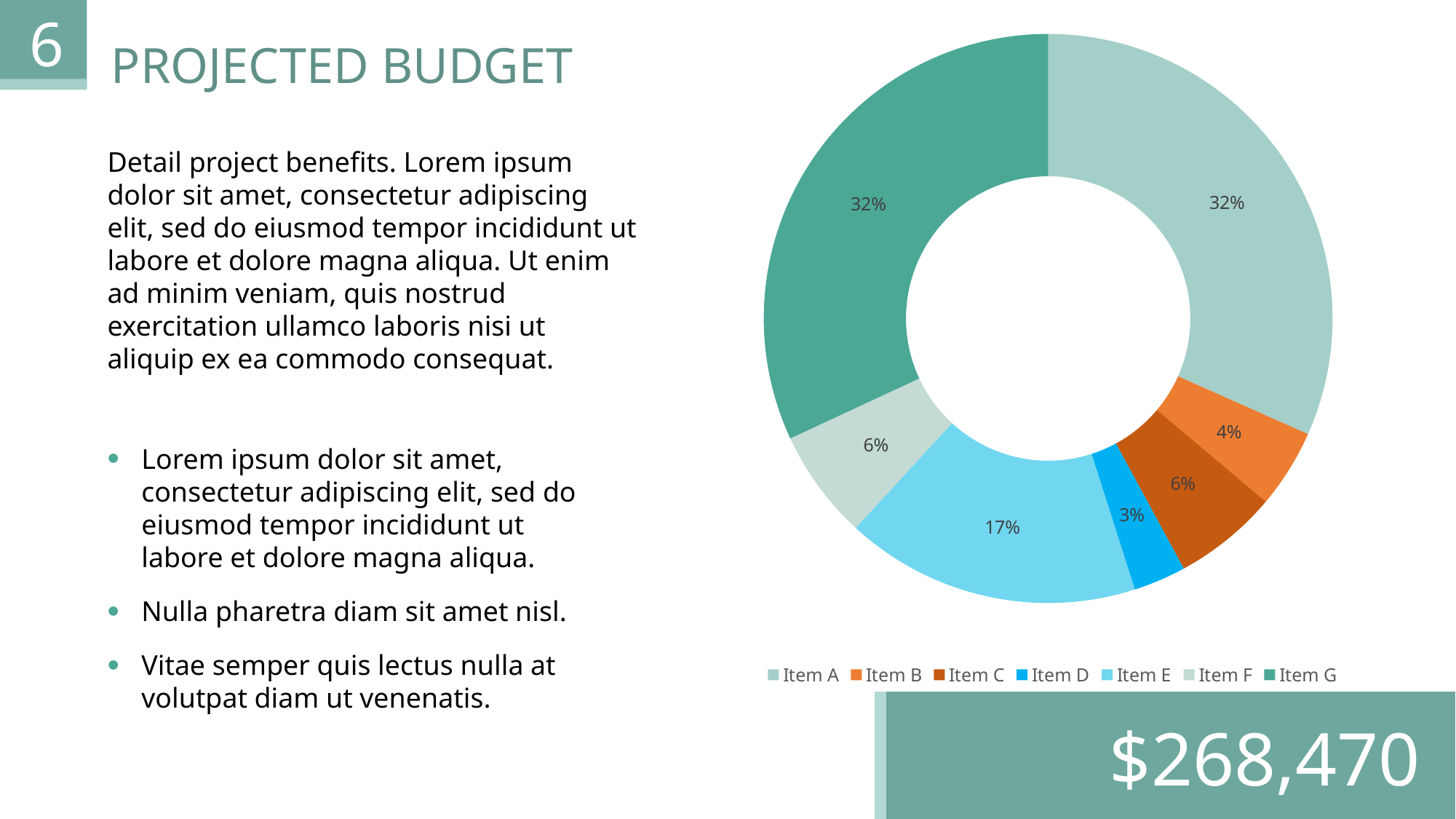
What is the title of the slide containing the chart? PROJECTED BUDGET What percentage share does Item E have in the chart? 17% What type of chart is shown on the slide? Doughnut chart How many items are shown in the chart? 7 What percentage share does Item G have in the chart? 32% What percentage share does Item C have in the chart? 6% What percentage share does Item D have in the chart? 3% Which has a larger share, Item B or Item C? Item C What is the difference in percentage points between Item E and Item F? 11 How many entries does the chart legend list? 7 What percentage share does Item B have in the chart? 4% Which item has the smallest share in the chart? Item D